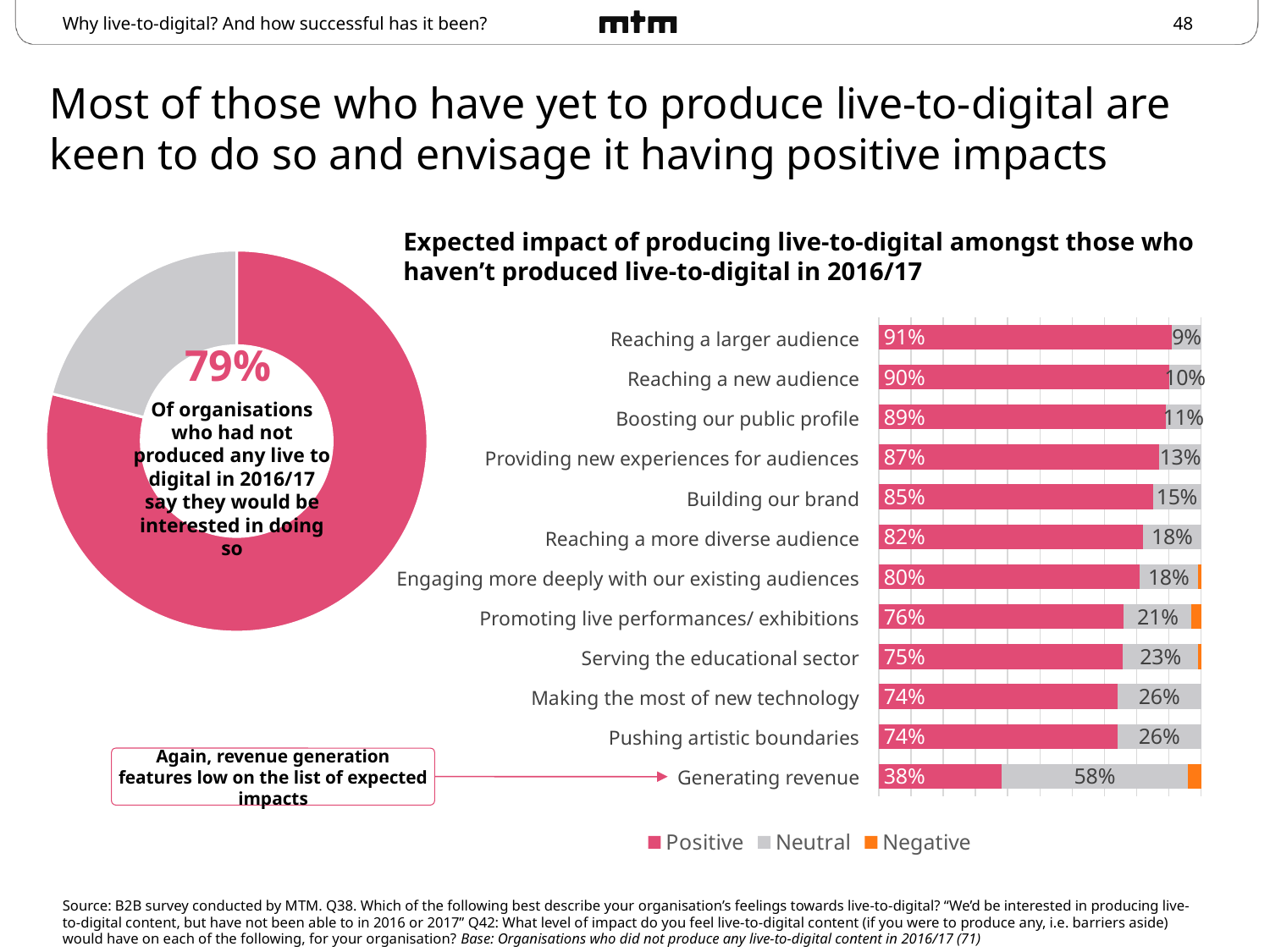
What kind of chart is the 'Expected impact of producing live-to-digital' chart? Stacked horizontal bar chart In the bar chart, which category has the highest Positive value? Reaching a larger audience In the bar chart, what is the Neutral value for 'Pushing artistic boundaries'? 26% In the bar chart, what is the Neutral value for 'Generating revenue'? 58% How many series does the bar chart's legend list? 3 In the chart on the left, what percentage of organisations that had not produced live-to-digital in 2016/17 say they would be interested in doing so? 79% What are the legend entries of the bar chart? Positive, Neutral, Negative How many categories are shown in the bar chart? 12 In the bar chart, which category has the lowest Positive value? Generating revenue In the bar chart, what is the difference between the Positive values for 'Reaching a larger audience' and 'Generating revenue'? 53 percentage points In the bar chart, what percentage of respondents expect a positive impact on 'Reaching a larger audience'? 91% In the bar chart, which has a larger Positive value: 'Building our brand' or 'Reaching a more diverse audience'? Building our brand